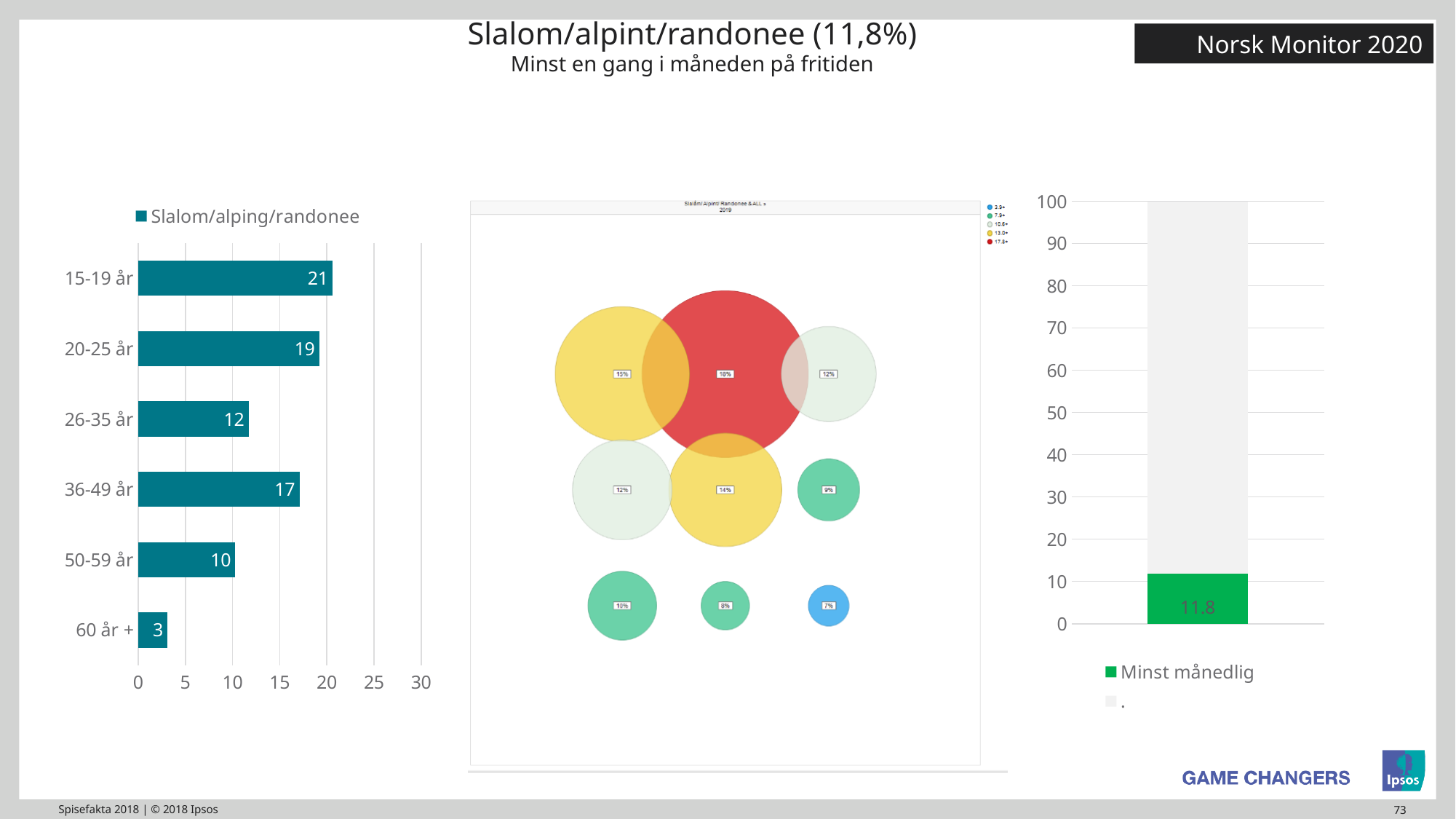
In the left bar chart, what is the value for the 60 år + age group? 3 In the left bar chart, which is larger: the value for 36-49 år or the value for 50-59 år? 36-49 år In the left bar chart, which age group has the highest value? 15-19 år How many age groups are shown in the left bar chart? 6 In the right-hand chart, is the value for 'Minst månedlig' greater or less than 20? less In the right-hand chart, what is the value labelled on the green 'Minst månedlig' bar? 11.8 In the left bar chart, what is the value for the 36-49 år age group? 17 In the left bar chart, what is the value for the 15-19 år age group? 21 In the left bar chart, which age group has the lowest value? 60 år + What type of chart is the chart on the left of the slide? Bar chart What is the series name shown in the legend of the left bar chart? Slalom/alping/randonee In the left bar chart, what is the difference between the values for 20-25 år and 26-35 år? 7